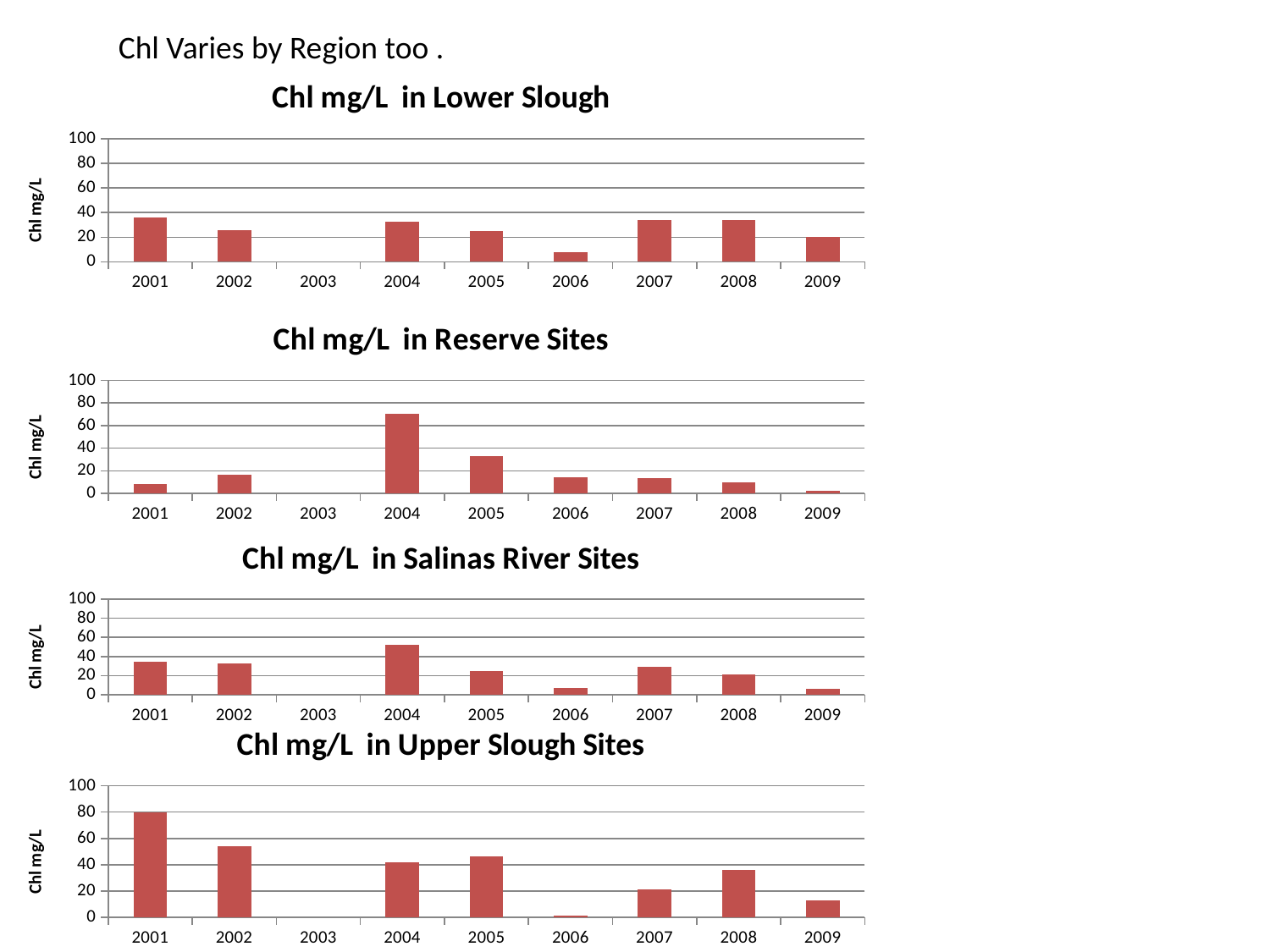
In the 'Chl mg/L in Reserve Sites' chart, is the value for 2004 greater or less than 60? greater In the 'Chl mg/L in Salinas River Sites' chart, is the value for 2004 greater or less than 40? greater In the 'Chl mg/L in Reserve Sites' chart, which is larger, the value for 2004 or the value for 2005? 2004 How many years are shown on the x axis of the 'Chl mg/L in Lower Slough' chart? 9 In the 'Chl mg/L in Salinas River Sites' chart, which year has the highest value? 2004 What kind of chart is 'Chl mg/L in Upper Slough Sites'? bar chart In the 'Chl mg/L in Lower Slough' chart, is the value for 2006 greater or less than 20? less In the 'Chl mg/L in Reserve Sites' chart, which year has the highest value? 2004 In the 'Chl mg/L in Upper Slough Sites' chart, which year has the highest value? 2001 How many charts are on the slide? 4 In the 'Chl mg/L in Upper Slough Sites' chart, which is larger, the value for 2001 or the value for 2002? 2001